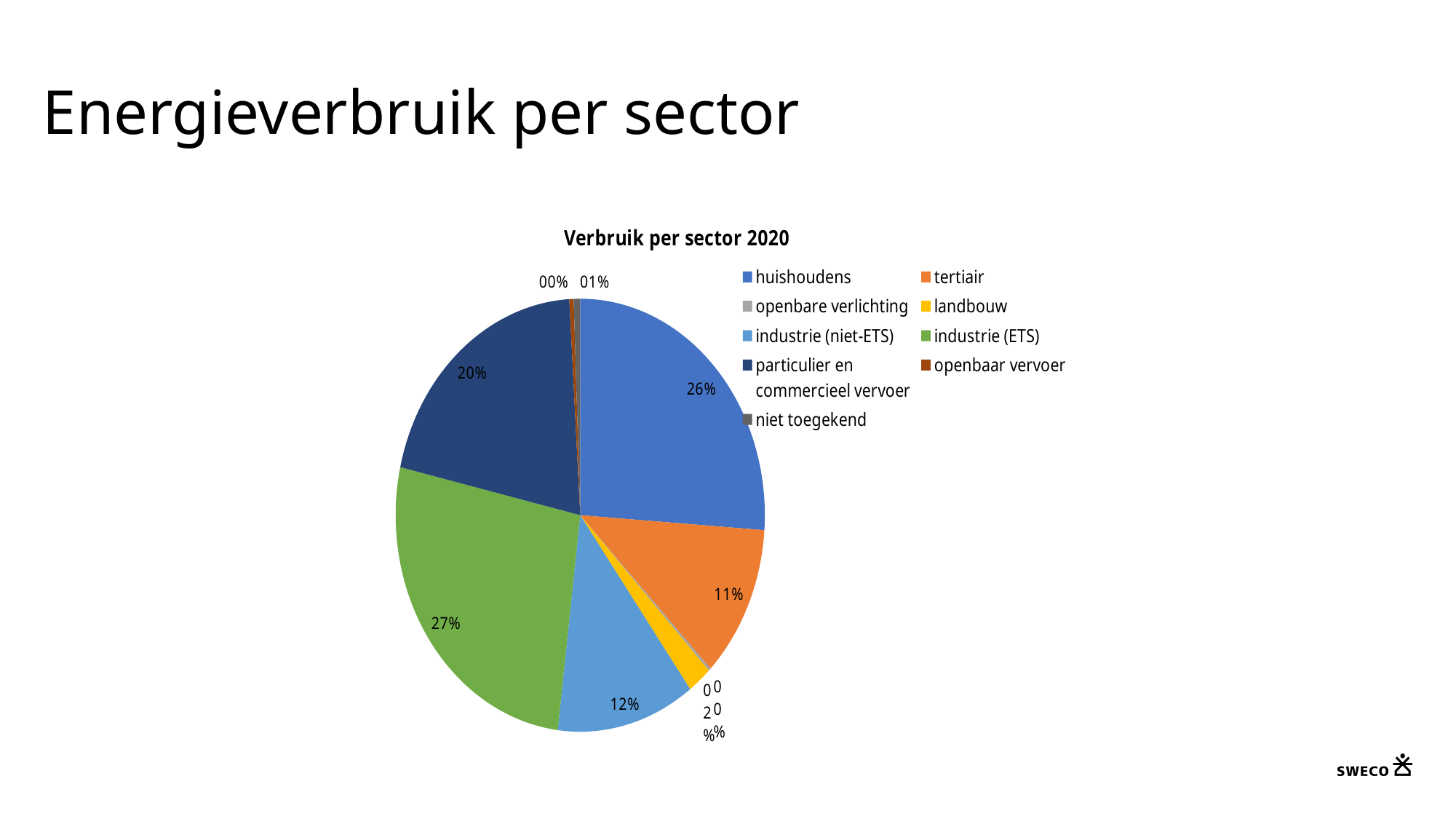
How many sectors does the legend list? 9 What share of the pie does particulier en commercieel vervoer have? 20% What share of the pie does tertiair have? 11% What share of the pie does huishoudens have? 26% What share of the pie does industrie (ETS) have? 27% What type of chart is shown on the slide? pie chart What share of the pie does industrie (niet-ETS) have? 12% Which sector has the largest share of the pie? industrie (ETS) What is the difference between the shares of huishoudens and tertiair? 15% What is the title of the chart? Verbruik per sector 2020 What is the difference between the shares of industrie (ETS) and industrie (niet-ETS)? 15% Which has a larger share: particulier en commercieel vervoer or industrie (niet-ETS)? particulier en commercieel vervoer